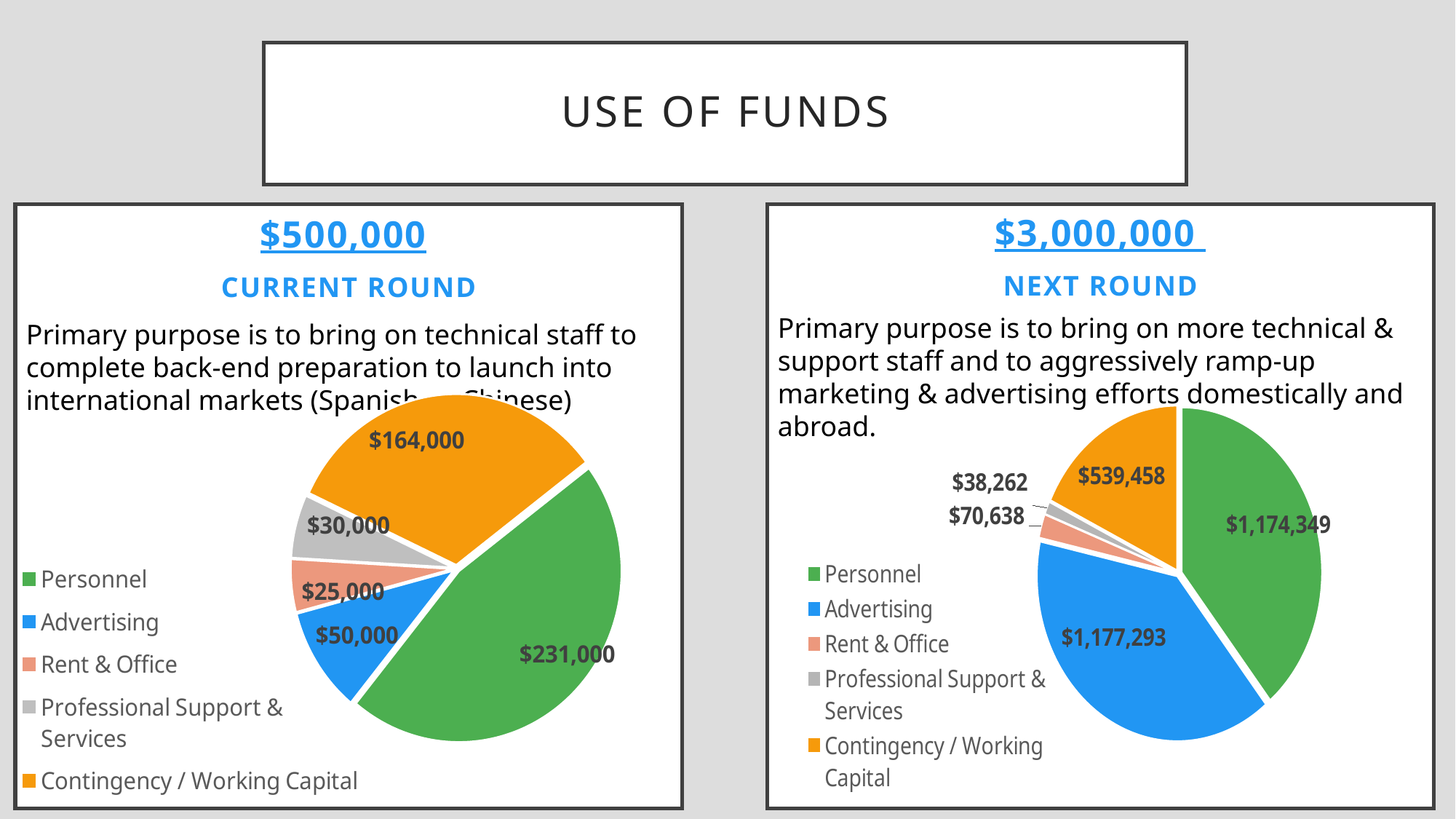
How many slices does the Next Round pie chart have? 5 In the Next Round chart, what is the value for Rent & Office? $70,638 In the Next Round chart, which category has the smallest value? Professional Support & Services In the Current Round chart, which category has the largest value? Personnel In the Current Round chart, what is the value for Personnel? $231,000 In the Next Round chart, what is the difference between Advertising and Personnel? $2,944 What type of chart is used in the Current Round panel? Pie chart In the Current Round chart, which is larger: Advertising or Professional Support & Services? Advertising In the Next Round chart, what is the value for Contingency / Working Capital? $539,458 In the Current Round chart, what share of the total does Rent & Office represent? 5% In the Current Round chart, what is the difference between Personnel and Contingency / Working Capital? $67,000 In the Current Round chart, which category has the smallest value? Rent & Office